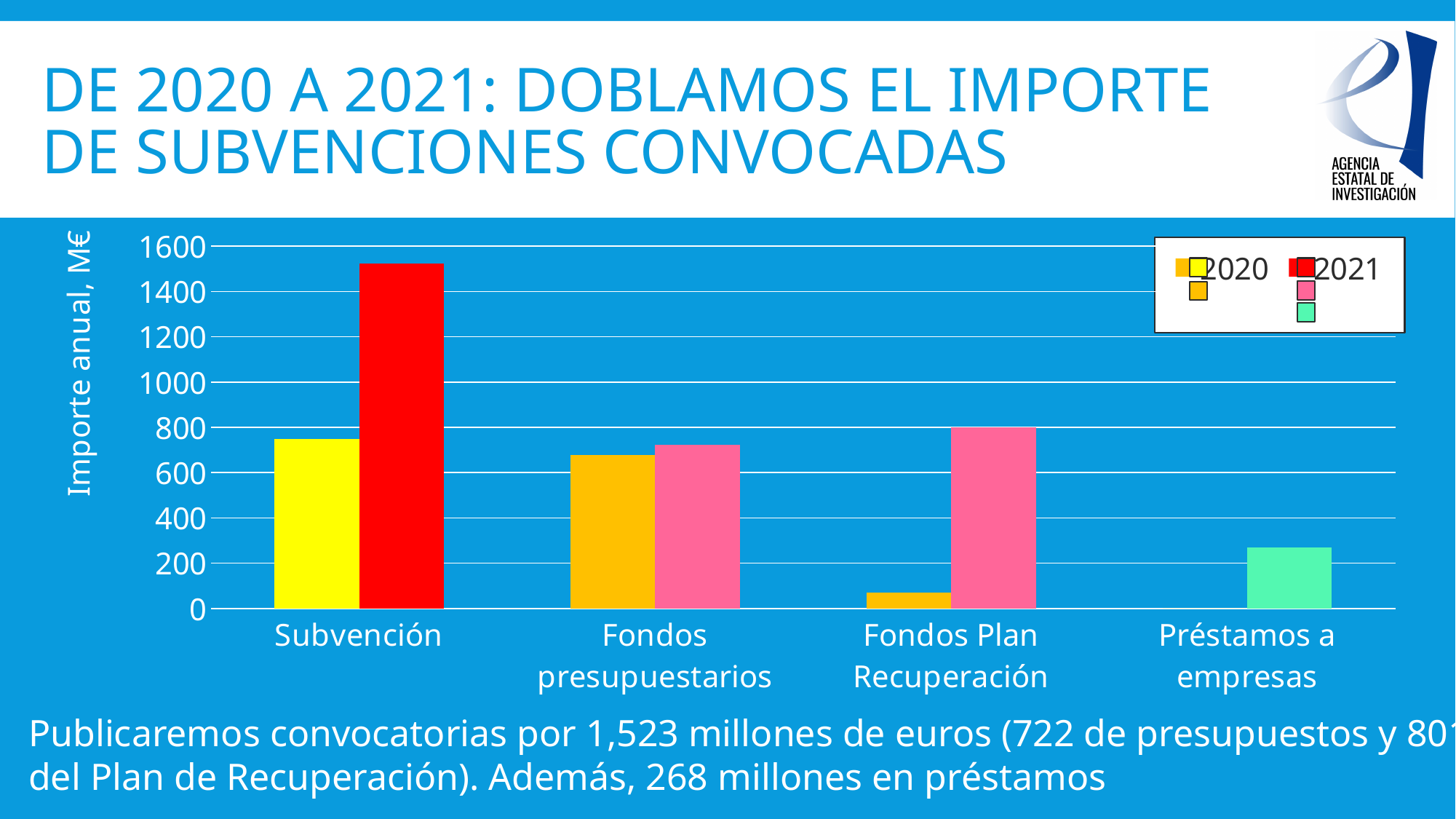
Is the 2021 value for Subvención greater or less than 1400? greater What kind of chart is shown on the slide? bar chart Which category has the lowest 2020 bar among those with a 2020 bar? Fondos Plan Recuperación Is the 2020 value for Fondos Plan Recuperación greater or less than 200? less Is the 2021 value for Préstamos a empresas greater or less than 400? less For Subvención, which year has the larger value, 2020 or 2021? 2021 What is the label of the vertical axis of the chart? Importe anual, M€ Which category has the highest 2021 value? Subvención For Fondos Plan Recuperación, which year has the larger value, 2020 or 2021? 2021 How many categories are shown on the x axis of the chart? 4 How many series does the chart legend list? 2